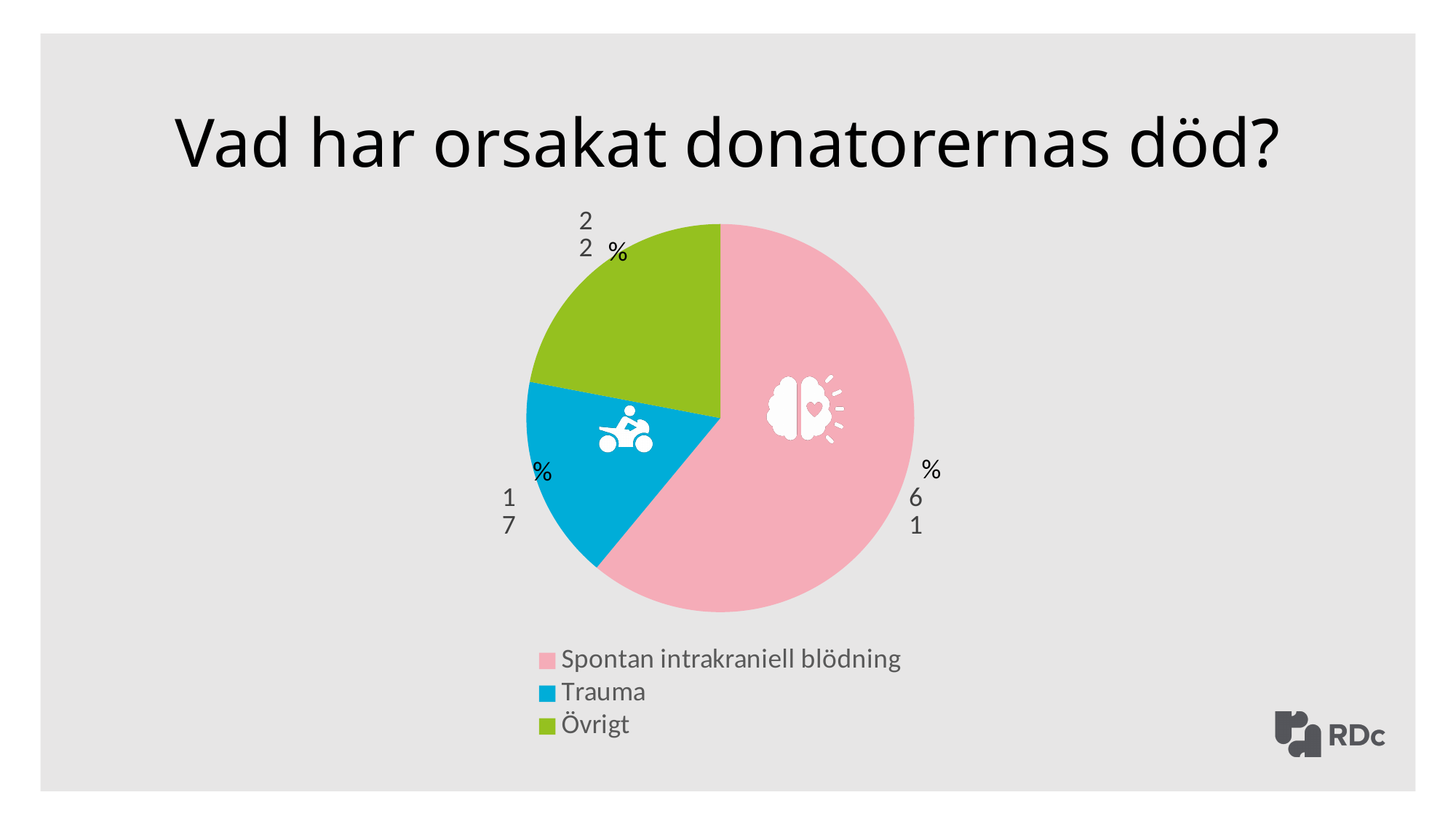
What is the difference in percentage points between Övrigt and Trauma? 5 What share of the pie is Spontan intrakraniell blödning? 61% What is the title of the chart? Vad har orsakat donatorernas död? Which category has the largest share of the pie? Spontan intrakraniell blödning Which category has the smallest share of the pie? Trauma What share of the pie is Trauma? 17% How many categories does the legend list? 3 Which is larger, the share for Övrigt or the share for Trauma? Övrigt What share of the pie is Övrigt? 22% What kind of chart is shown on the slide? pie chart Which colour represents Trauma in the pie chart? blue What is the difference in percentage points between Spontan intrakraniell blödning and Trauma? 44